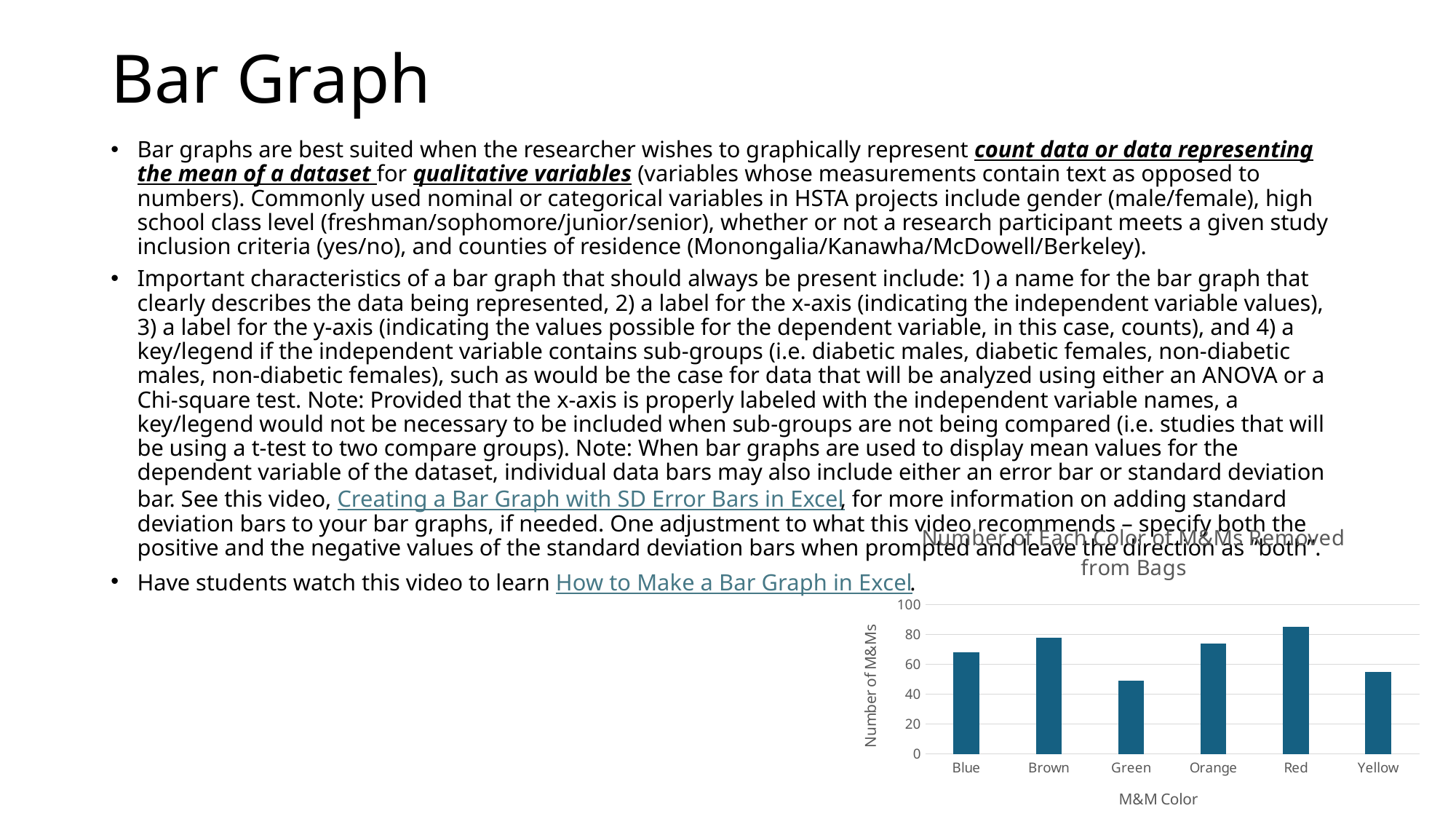
Which has a larger value, Brown or Yellow? Brown Is the value for Red greater or less than 80? greater How many M&M colors are shown on the x axis of the chart? 6 What is the label on the y axis of the chart? Number of M&Ms What kind of chart is shown on the slide? bar chart What is the title of the chart? Number of Each Color of M&Ms Removed from Bags Which M&M color has the highest number of M&Ms removed? Red Is the value for Blue greater or less than 60? greater Is the value for Yellow greater or less than 40? greater Which has a larger value, Green or Orange? Orange Which M&M color has the lowest number of M&Ms removed? Green